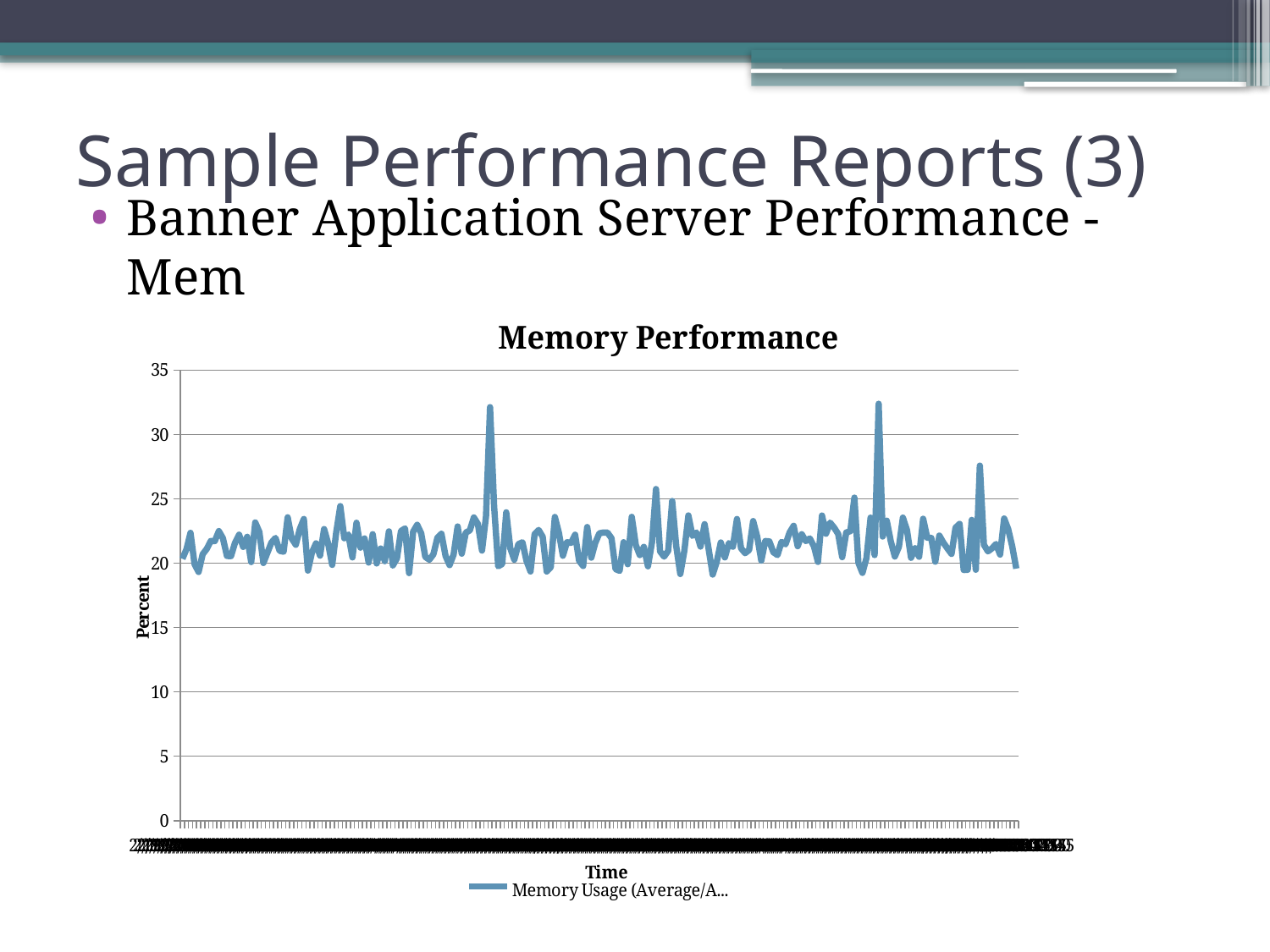
What is the label of the vertical axis of the chart? Percent What is the title of the chart? Memory Performance What kind of chart is shown on the slide? line chart Is the lowest value plotted on the Memory Performance chart greater or less than 25? less Is the lowest value plotted on the Memory Performance chart greater or less than 15? greater Is the highest value plotted on the Memory Performance chart greater or less than 35? less How many series does the chart's legend list? 1